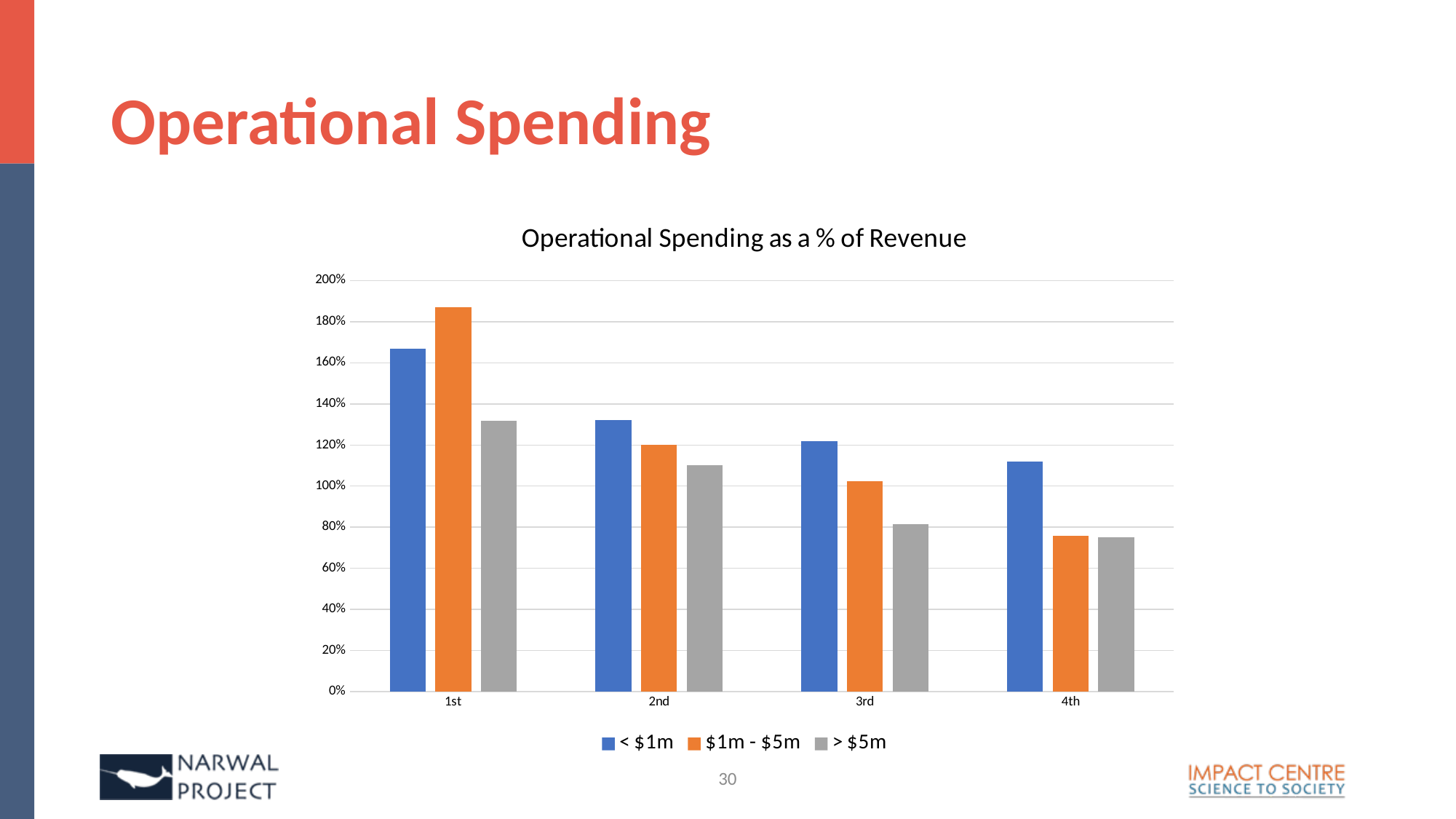
Is the value for $1m - $5m in the 4th category greater or less than 80%? less In the 2nd category, which is larger: the < $1m bar or the > $5m bar? < $1m How many series does the legend list? 3 Is the value for < $1m in the 4th category greater or less than 100%? greater What is the title of the chart? Operational Spending as a % of Revenue Do the values for the < $1m series rise or fall from the 1st to the 4th category? fall How many categories are shown on the x axis? 4 Which series has the highest bar in the 4th category? < $1m Which series has the highest bar in the 1st category? $1m - $5m Is the value for > $5m in the 1st category greater or less than 140%? less What kind of chart is shown on the slide? bar chart